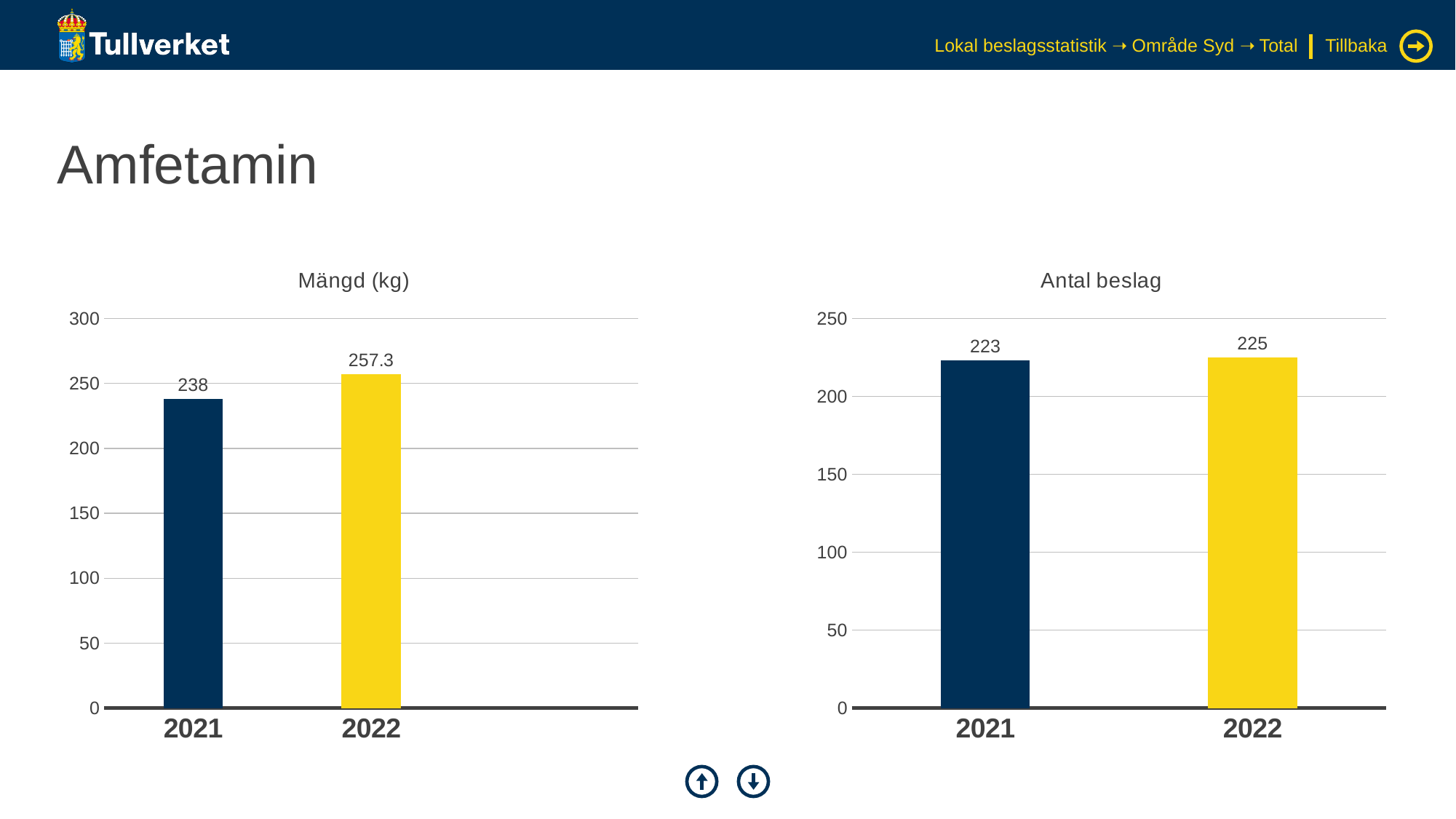
In the 'Mängd (kg)' chart, what is the difference between the 2022 and 2021 values? 19.3 In the 'Mängd (kg)' chart, is the value for 2021 greater or less than 250? less In the 'Mängd (kg)' chart, do the values rise or fall from 2021 to 2022? rise In the 'Antal beslag' chart, is the value for 2022 greater or less than 200? greater In the 'Antal beslag' chart, what is the value for 2022? 225 In the 'Antal beslag' chart, what is the value for 2021? 223 In the 'Mängd (kg)' chart, what is the value for 2022? 257.3 In the 'Mängd (kg)' chart, which year has the highest value? 2022 How many categories are shown in the 'Antal beslag' chart? 2 In the 'Mängd (kg)' chart, what is the value for 2021? 238 What kind of chart is the 'Mängd (kg)' chart? bar chart In the 'Antal beslag' chart, what is the difference between the 2022 and 2021 values? 2